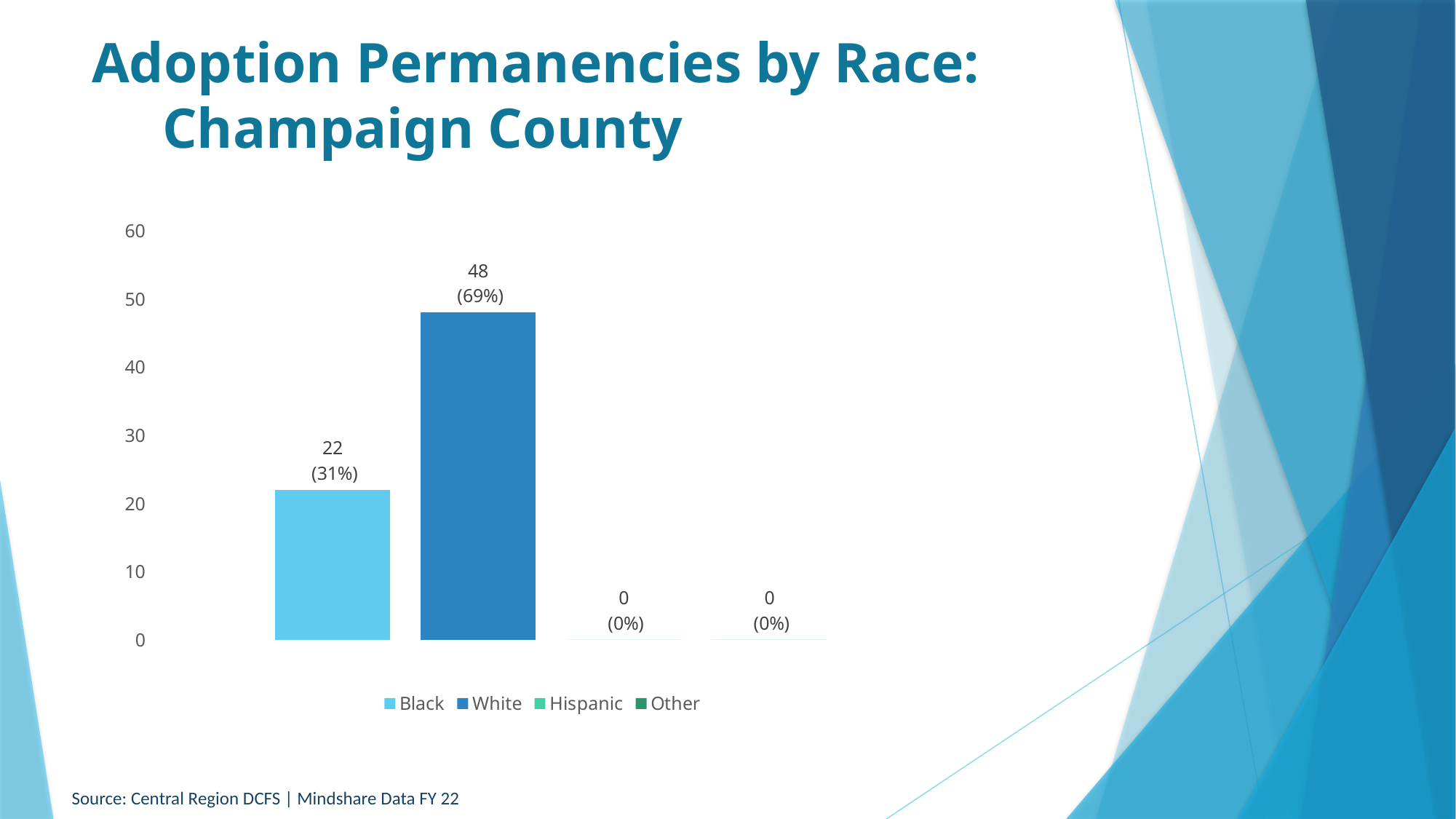
What is the total of the values for Black and White? 70 What is the title of the slide? Adoption Permanencies by Race: Champaign County What is the value for White? 48 What is the difference between the values for White and Black? 26 Which is larger, the value for Black or the value for White? White Which category has the highest value? White What percentage is shown for Black? 31% How many categories does the legend list? 4 What kind of chart is shown on the slide? Bar chart What is the value for Hispanic? 0 Is the value for White greater or less than 40? greater What is the value for Black? 22